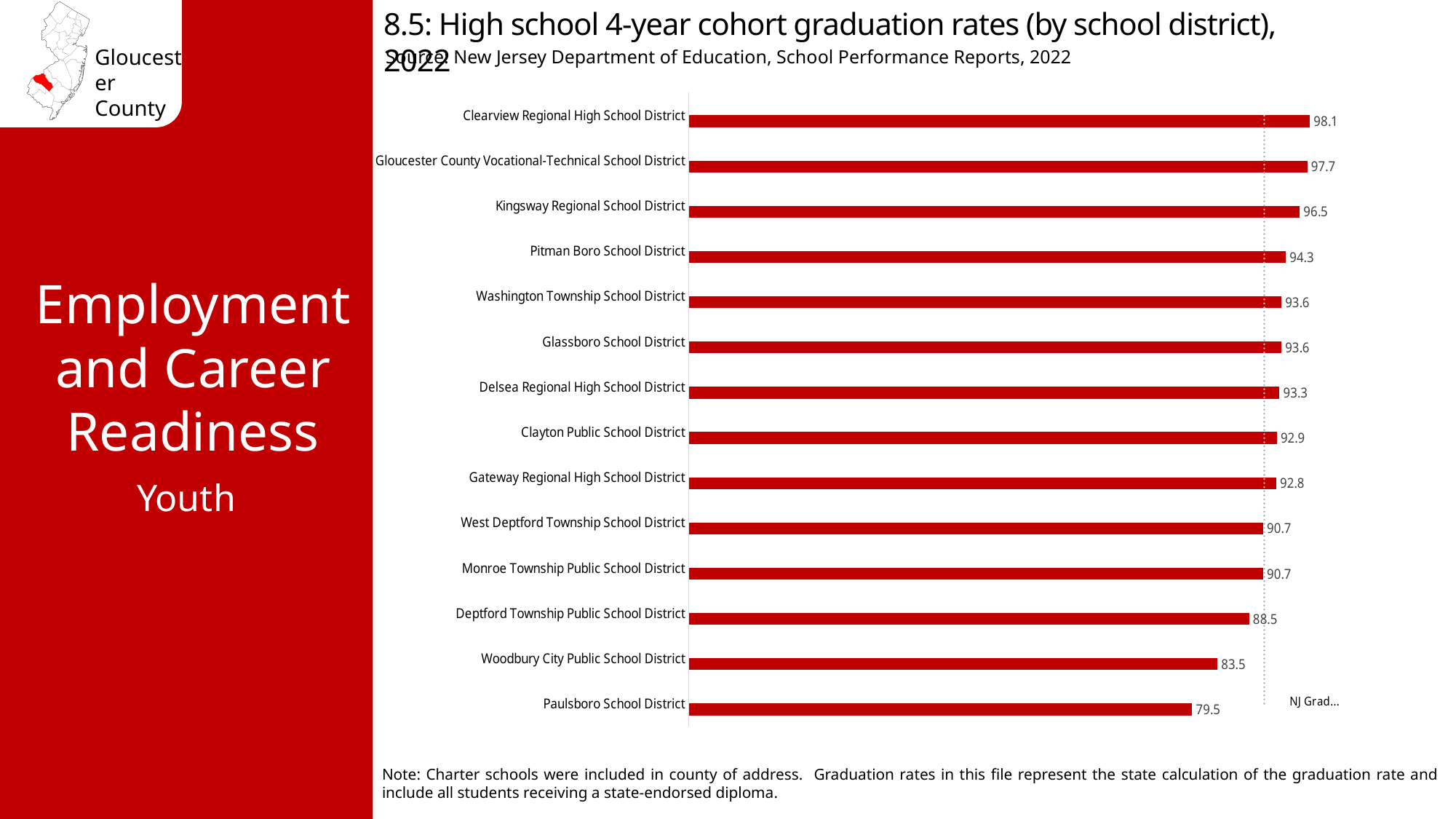
Do the graduation rates increase or decrease going from the top of the chart to the bottom? Decrease What is the graduation rate for Kingsway Regional School District? 96.5 What is the difference between the graduation rates of Clearview Regional High School District and Paulsboro School District? 18.6 What is the difference between the graduation rates of Kingsway Regional School District and Pitman Boro School District? 2.2 Which has a higher graduation rate, Woodbury City Public School District or Deptford Township Public School District? Deptford Township Public School District What is the graduation rate for Paulsboro School District? 79.5 Which school district has the highest graduation rate? Clearview Regional High School District Which school district has the lowest graduation rate? Paulsboro School District What type of chart is used on this slide? Bar chart What is the graduation rate for Clearview Regional High School District? 98.1 How many school districts are shown in the chart? 14 What is the graduation rate for Deptford Township Public School District? 88.5